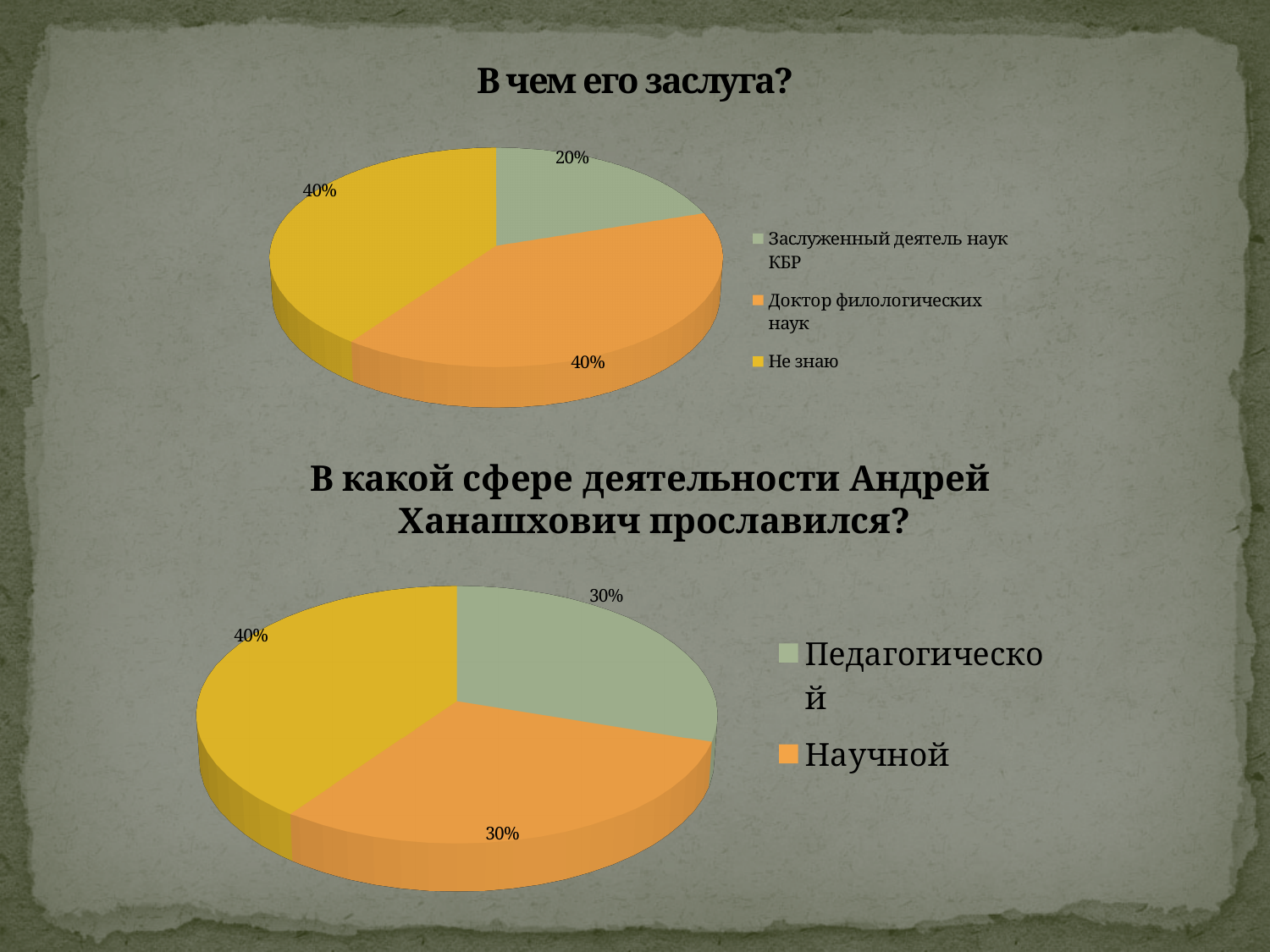
In the top chart titled "В чем его заслуга?", how many slices does the pie have? 3 What kind of chart is the top chart titled "В чем его заслуга?"? Pie chart In the top chart titled "В чем его заслуга?", what share of respondents answered "Заслуженный деятель наук КБР"? 20% In the bottom chart titled "В какой сфере деятельности Андрей Ханашхович прославился?", what share of respondents answered "Педагогической"? 30% In the top chart titled "В чем его заслуга?", what share of respondents answered "Доктор филологических наук"? 40% In the top chart titled "В чем его заслуга?", what share of respondents answered "Не знаю"? 40% In the bottom chart titled "В какой сфере деятельности Андрей Ханашхович прославился?", what colour is the slice for "Научной"? Orange In the top chart titled "В чем его заслуга?", which category has the smallest share? Заслуженный деятель наук КБР In the top chart titled "В чем его заслуга?", how many entries does the legend list? 3 In the bottom chart titled "В какой сфере деятельности Андрей Ханашхович прославился?", what share of respondents answered "Научной"? 30% In the bottom chart titled "В какой сфере деятельности Андрей Ханашхович прославился?", how many slices does the pie have? 3 In the top chart titled "В чем его заслуга?", what is the difference between the share for "Не знаю" and the share for "Заслуженный деятель наук КБР"? 20%